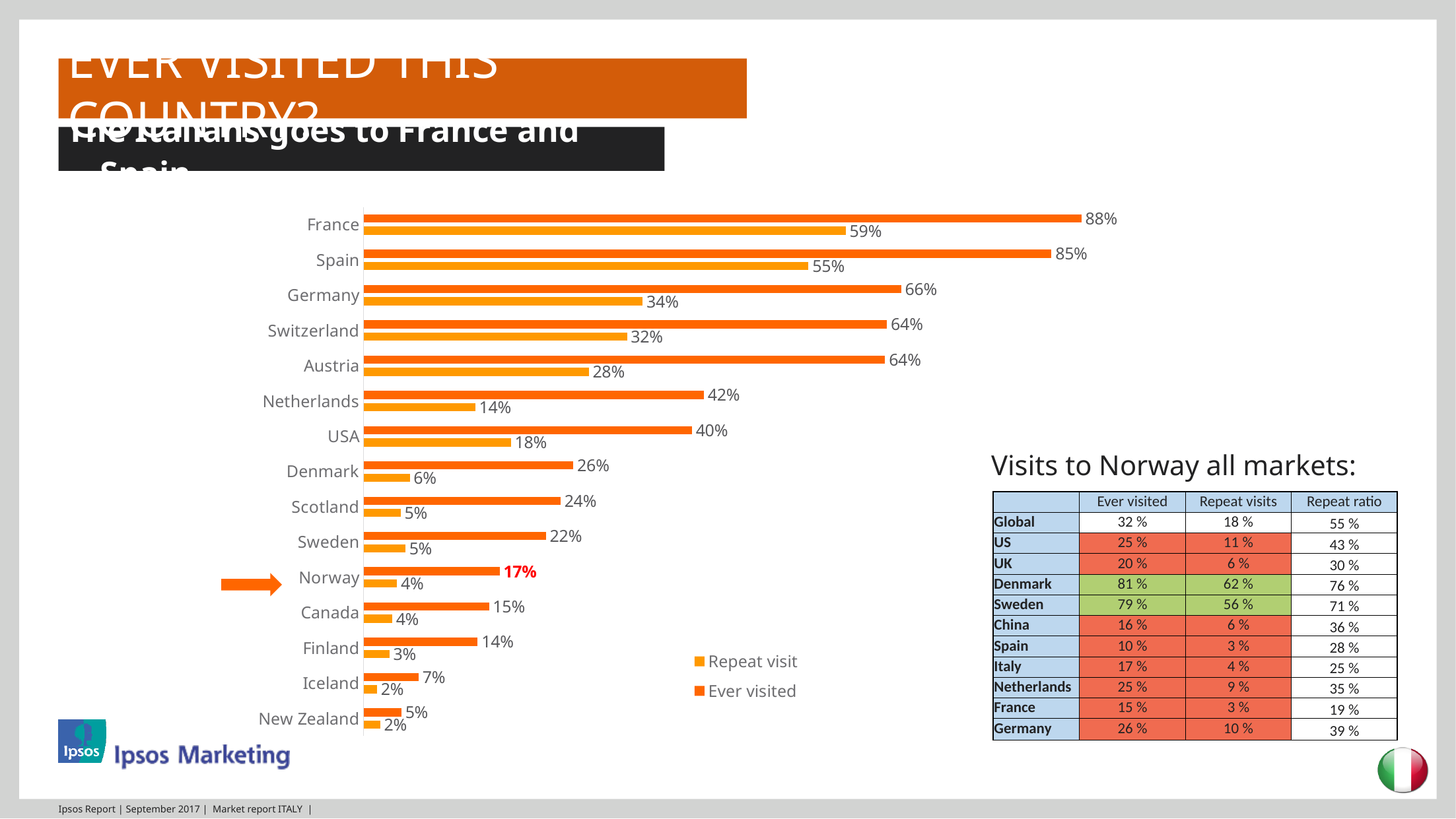
Which series is shown in the lighter orange colour in the legend? Repeat visit How many countries are shown in the bar chart? 15 What is the 'Repeat visit' value for Iceland? 2% How many series does the legend list? 2 Which country has the highest 'Ever visited' value? France What is the 'Ever visited' value for France? 88% Which country has the lowest 'Ever visited' value? New Zealand What is the difference between the 'Ever visited' and 'Repeat visit' values for Spain? 30% What is the 'Repeat visit' value for Germany? 34% What is the 'Ever visited' value for Norway? 17% Which is larger, the 'Repeat visit' value for the USA or for the Netherlands? USA What kind of chart is shown on the slide? Bar chart